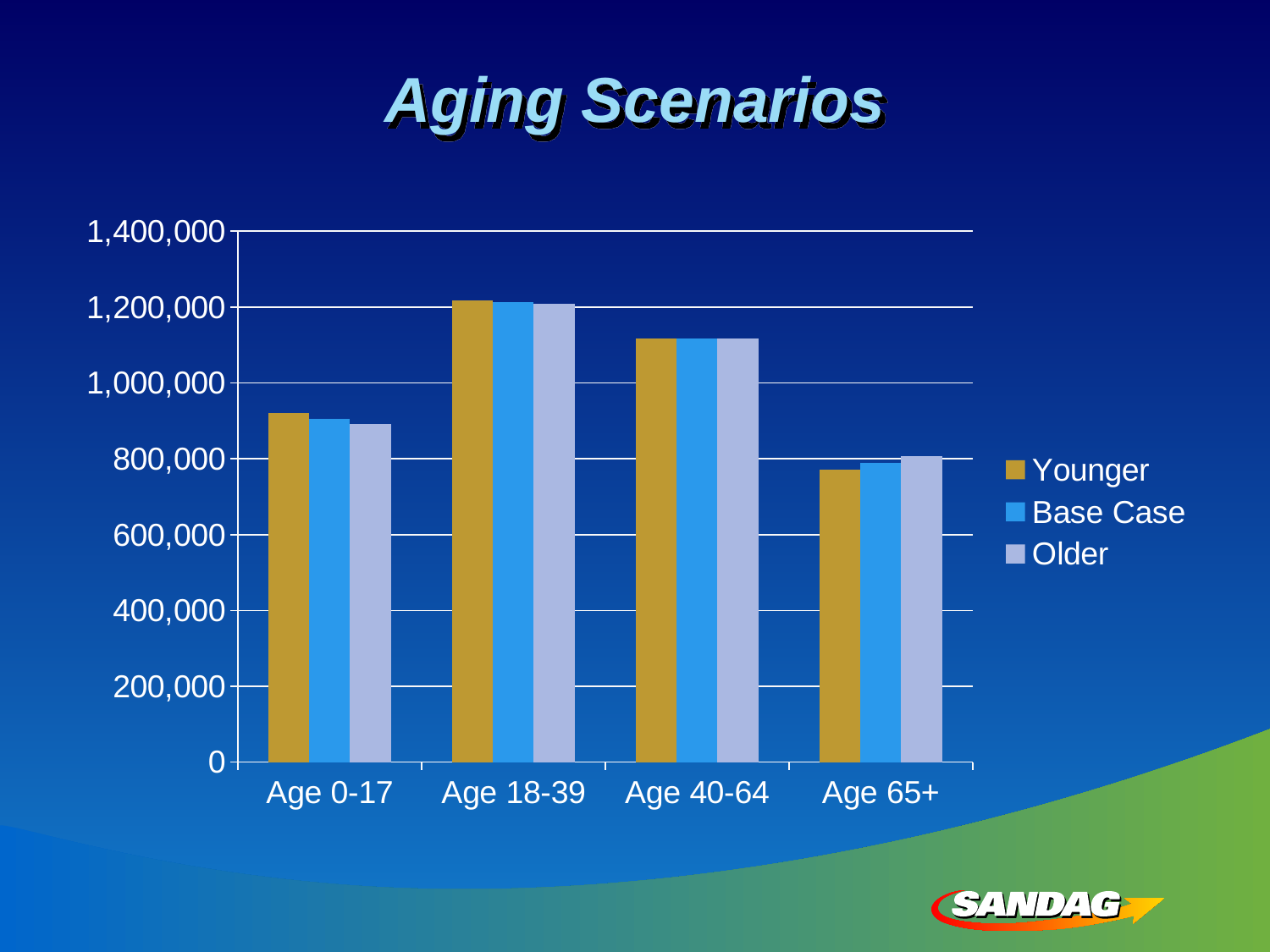
How many age categories are shown on the x axis? 4 How many series does the legend list? 3 Is the Older value for Age 40-64 greater or less than 1,000,000? greater Is the Base Case value for Age 0-17 greater or less than 1,000,000? less Which series is shown in gold/yellow bars? Younger What kind of chart is shown on the slide? Bar chart What is the title of the chart? Aging Scenarios For the Base Case series, which is larger: Age 18-39 or Age 40-64? Age 18-39 Which age category has the lowest values across all scenarios? Age 65+ Is the Younger value for Age 65+ greater or less than 800,000? less Which age category has the highest values across all scenarios? Age 18-39